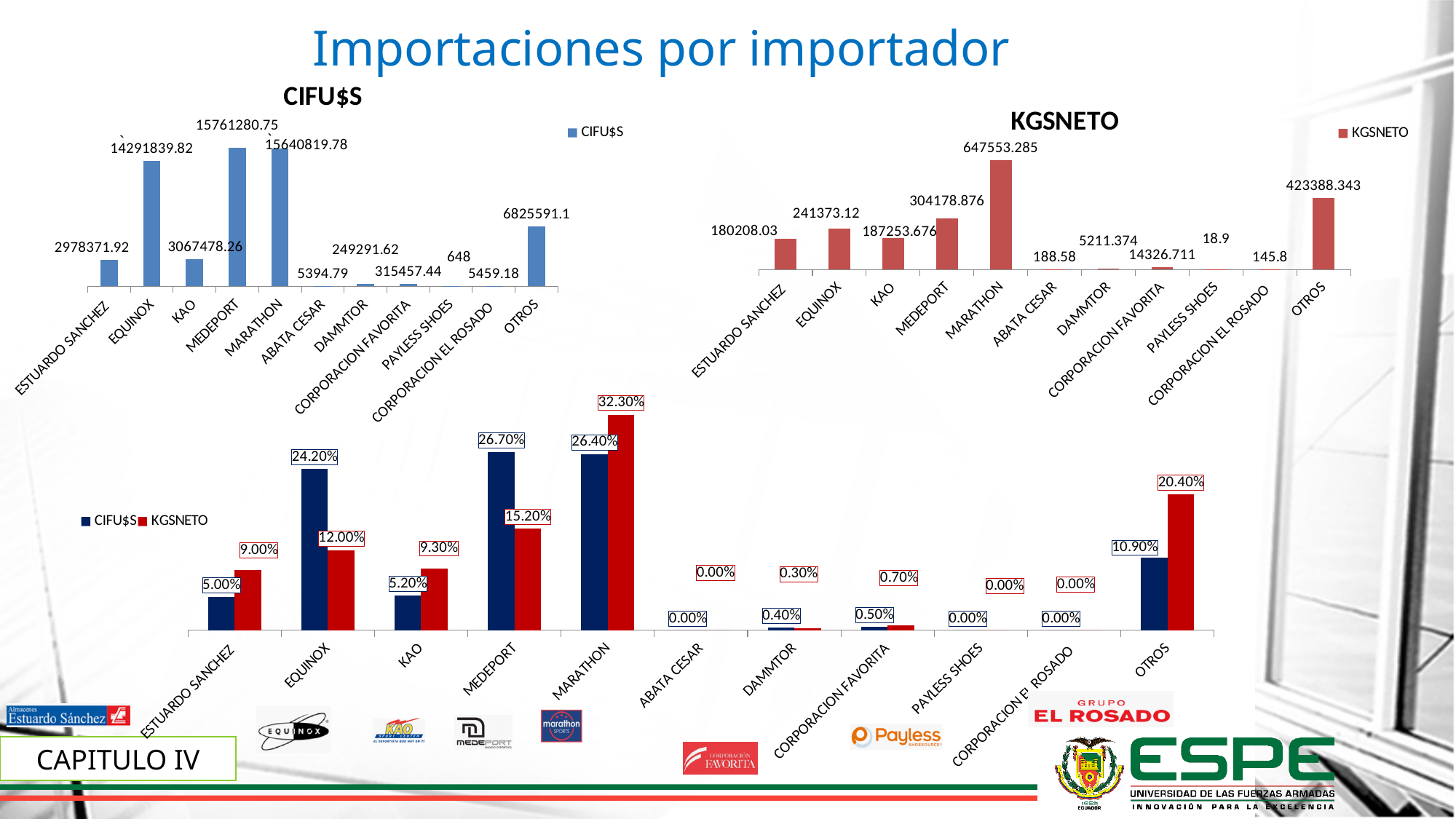
In the CIFU$S chart, which importer has the highest value? MEDEPORT In the CIFU$S chart, what is the value for EQUINOX? 14291839.82 In the bottom chart, what is the KGSNETO percentage for MARATHON? 32.30% In the bottom chart, what is the difference between the CIFU$S and KGSNETO percentages for MEDEPORT? 11.50% In the KGSNETO chart, which importer has the highest value? MARATHON In the KGSNETO chart, what is the value for MARATHON? 647553.285 In the KGSNETO chart, how many importers are shown on the x axis? 11 What type of chart is the CIFU$S chart at the top left? Bar chart How many series does the legend of the bottom chart list? 2 In the bottom chart, what is the CIFU$S percentage for OTROS? 10.90% In the CIFU$S chart, which importer has the lowest value? PAYLESS SHOES In the KGSNETO chart, which is larger, the value for EQUINOX or the value for OTROS? OTROS